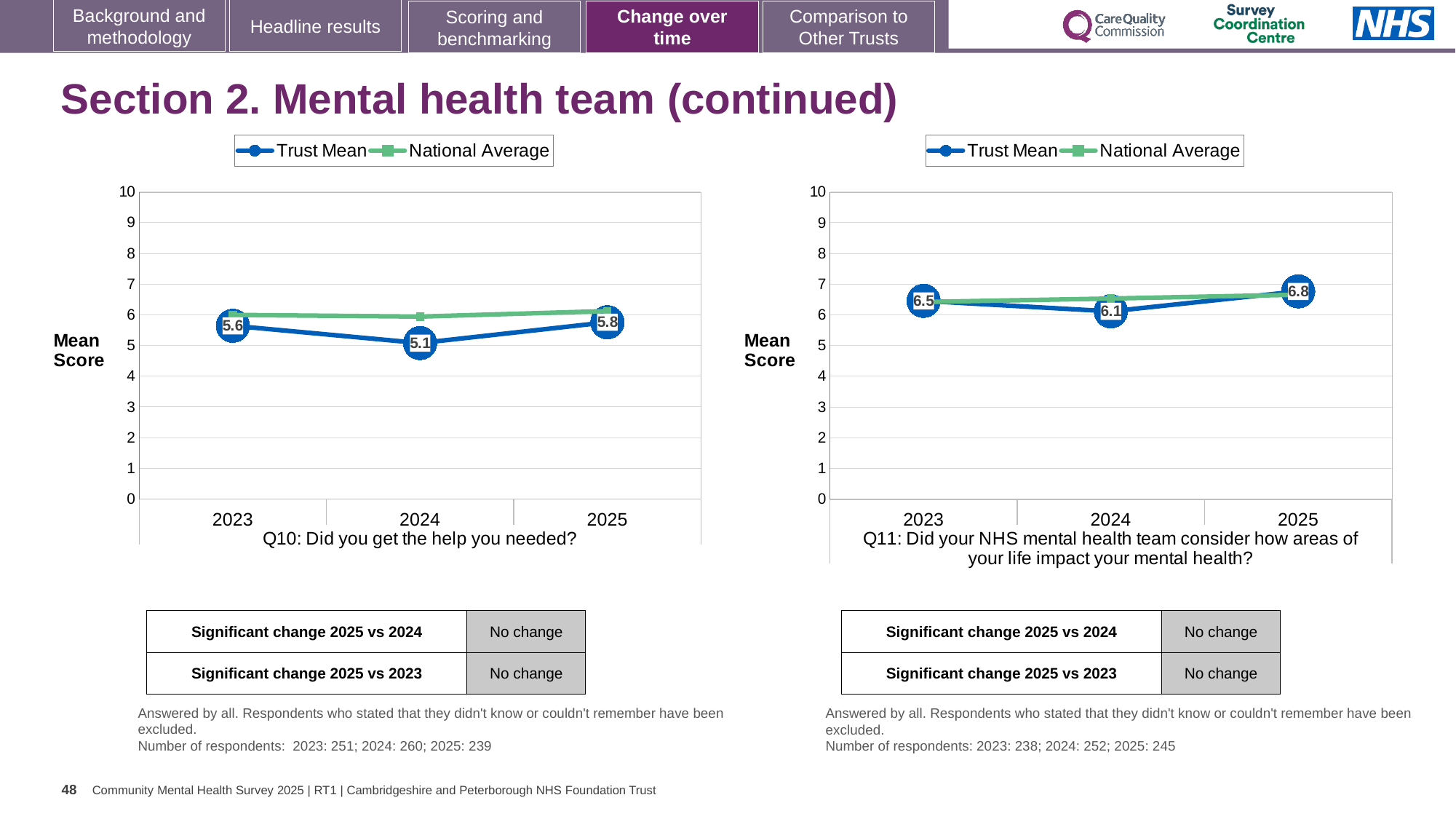
How many years are plotted on the x axis of the Q10 chart? 3 In the Q10 chart (Did you get the help you needed?), what is the Trust Mean for 2024? 5.1 In the Q11 chart, is the National Average for 2024 greater or less than 6? greater In the Q11 chart, which year has the lowest Trust Mean? 2024 In the Q11 chart, does the Trust Mean rise or fall from 2024 to 2025? Rise In the Q10 chart, what is the difference between the Trust Mean for 2025 and the Trust Mean for 2024? 0.7 In the Q11 chart, what is the difference between the Trust Mean for 2023 and the Trust Mean for 2024? 0.4 In the Q10 chart, which year has the highest Trust Mean? 2025 What kind of chart is the Q10 chart? Line chart How many series does the legend of the Q11 chart list? 2 In the Q10 chart, which is larger in 2024: the Trust Mean or the National Average? National Average In the Q11 chart (Did your NHS mental health team consider how areas of your life impact your mental health?), what is the Trust Mean for 2025? 6.8